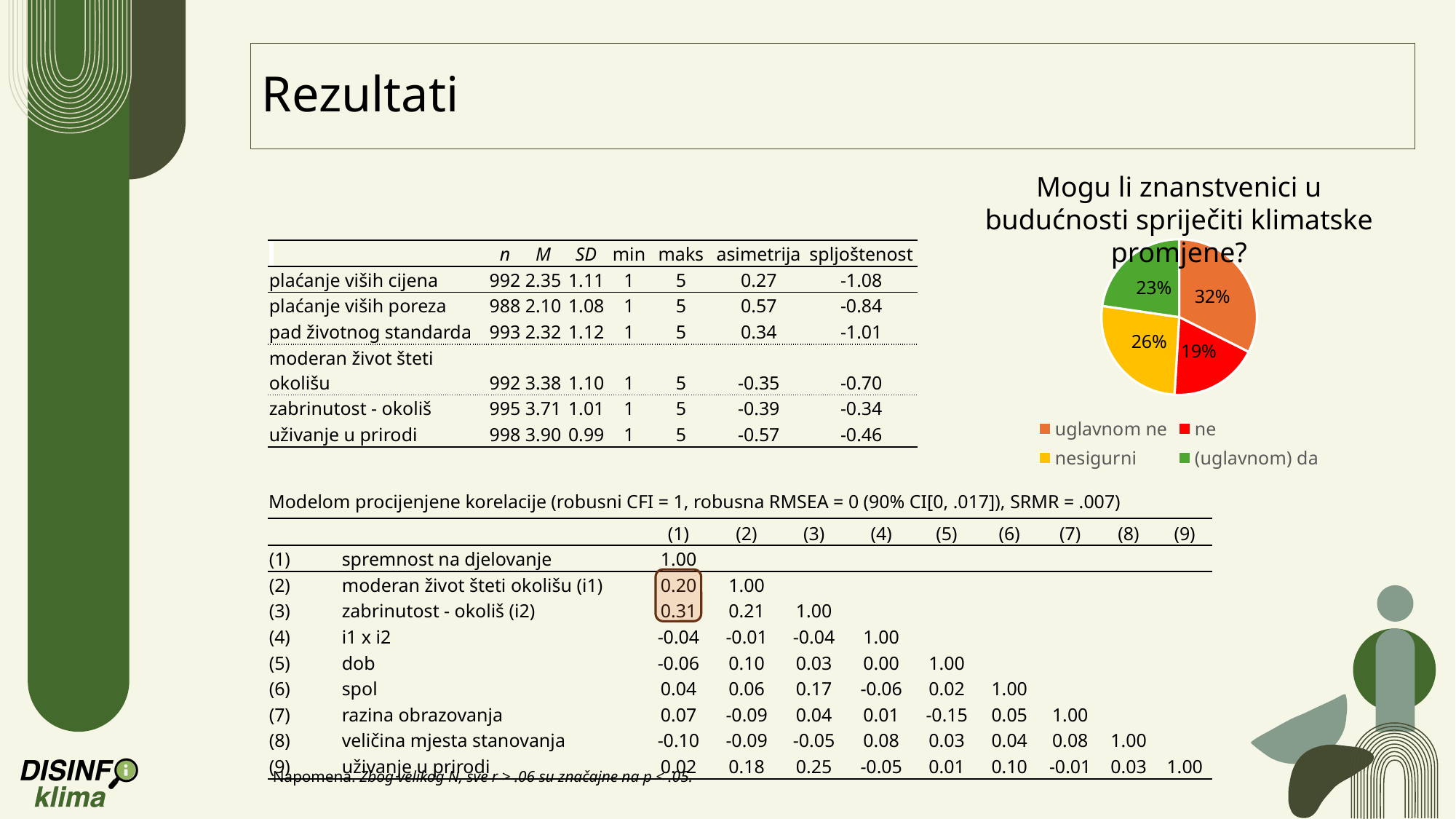
How many categories does the pie chart's legend list? 4 In the pie chart, what share is labelled for "ne"? 19% What is the title of the pie chart? Mogu li znanstvenici u budućnosti spriječiti klimatske promjene? In the pie chart, what share is labelled for "uglavnom ne"? 32% Which category has the smallest slice in the pie chart? ne What colour is the "nesigurni" slice in the pie chart? yellow Which category has the largest slice in the pie chart? uglavnom ne In the pie chart, which is larger: the share for "nesigurni" or the share for "(uglavnom) da"? nesigurni In the pie chart, what is the difference between the shares for "uglavnom ne" and "ne"? 13% In the pie chart, what share is labelled for "(uglavnom) da"? 23% In the pie chart, what share is labelled for "nesigurni"? 26% What kind of chart is shown on the slide? pie chart